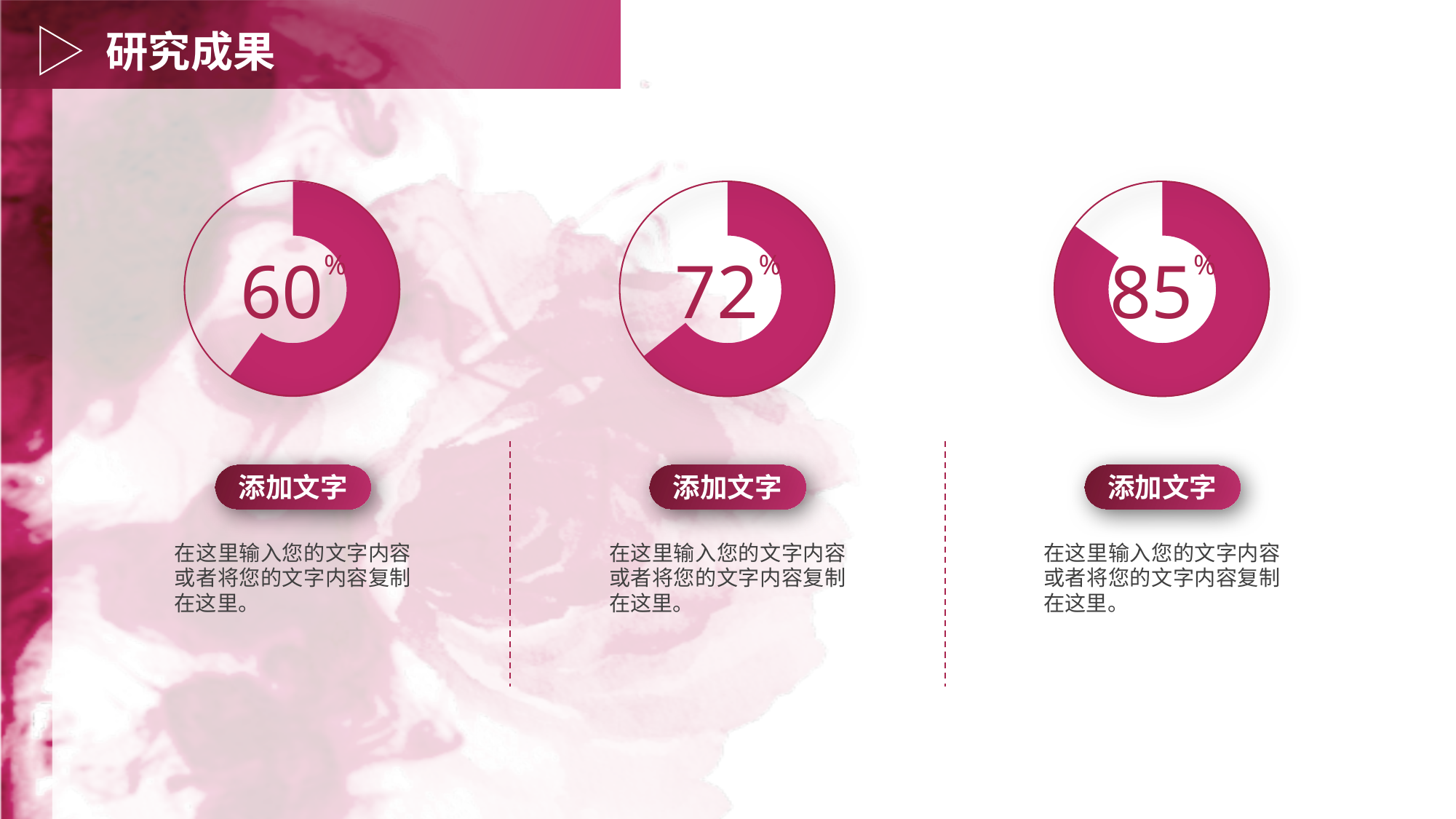
What is the difference between the value in the middle chart and the value in the left chart? 12% Do the percentage values increase or decrease from the left chart to the right chart? Increase Which of the three charts on the slide shows the lowest percentage? The left chart (60%) What is the title of the slide containing the three charts? 研究成果 How many circular percentage charts are on the slide? 3 What is the difference between the value in the right chart and the value in the left chart? 25% What value is shown in the middle chart on the slide? 72% What value is shown in the left chart on the slide? 60% What kind of chart is used to show the percentages on the slide? Pie (donut) chart What value is shown in the right chart on the slide? 85% Which is larger, the value in the middle chart or the value in the right chart? The right chart (85%) Which of the three charts on the slide shows the highest percentage? The right chart (85%)